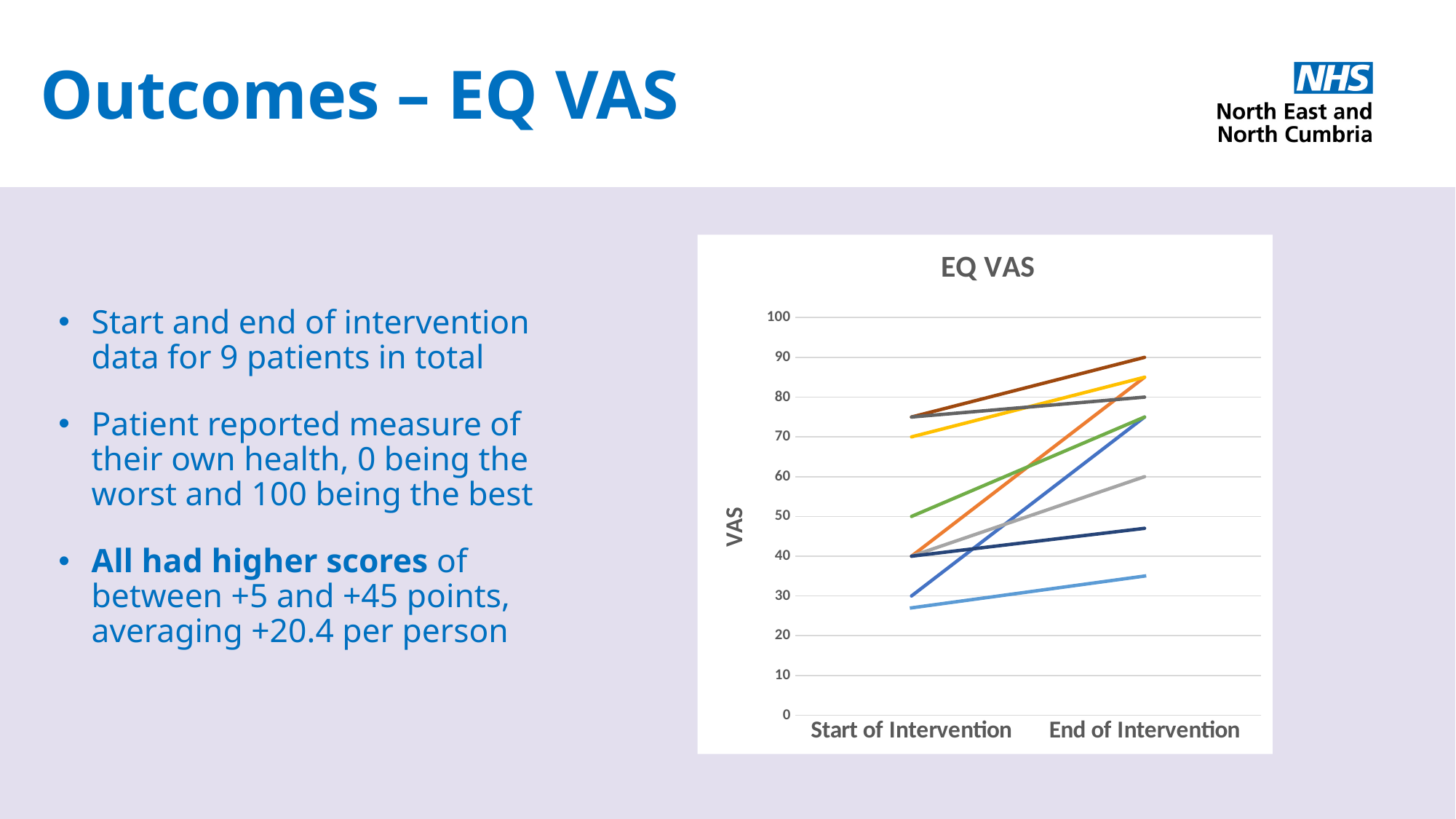
Is the highest value at Start of Intervention greater or less than 70? greater Is the lowest value at End of Intervention greater or less than 40? less How many categories are shown on the x axis of the chart? 2 How many lines (patients) are plotted on the chart? 9 Do the lines on the chart rise or fall from Start of Intervention to End of Intervention? rise What is the highest value shown on the vertical axis of the chart? 100 What is the label on the vertical axis of the chart? VAS What kind of chart is shown on the slide? line chart Is the lowest value at Start of Intervention greater or less than 30? less Which x-axis category has the higher maximum VAS value, Start of Intervention or End of Intervention? End of Intervention What is the highest VAS value reached at End of Intervention on the chart? 90 What is the title of the chart? EQ VAS